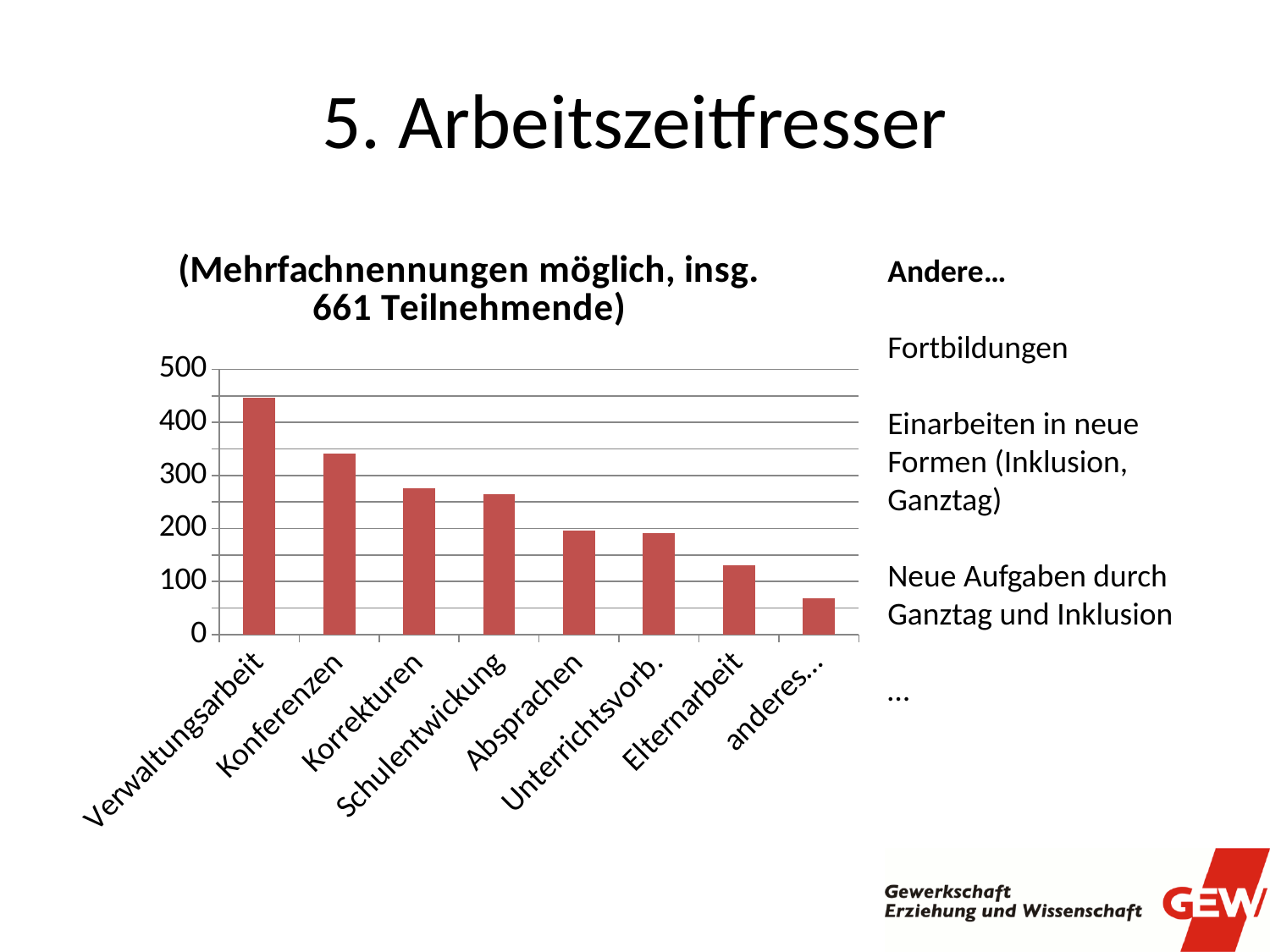
Which category has the highest value in the chart? Verwaltungsarbeit Is the value for Verwaltungsarbeit greater or less than 400? greater Which is larger, the value for Konferenzen or the value for Korrekturen? Konferenzen What is the title of the chart? (Mehrfachnennungen möglich, insg. 661 Teilnehmende) Is the value for Konferenzen greater or less than 300? greater Do the values rise or fall from left to right along the x axis? fall Is the value for anderes… greater or less than 100? less How many categories are shown on the x axis of the chart? 8 What kind of chart is shown on the slide? bar chart Which category has the lowest value in the chart? anderes… Which is larger, the value for Absprachen or the value for Elternarbeit? Absprachen